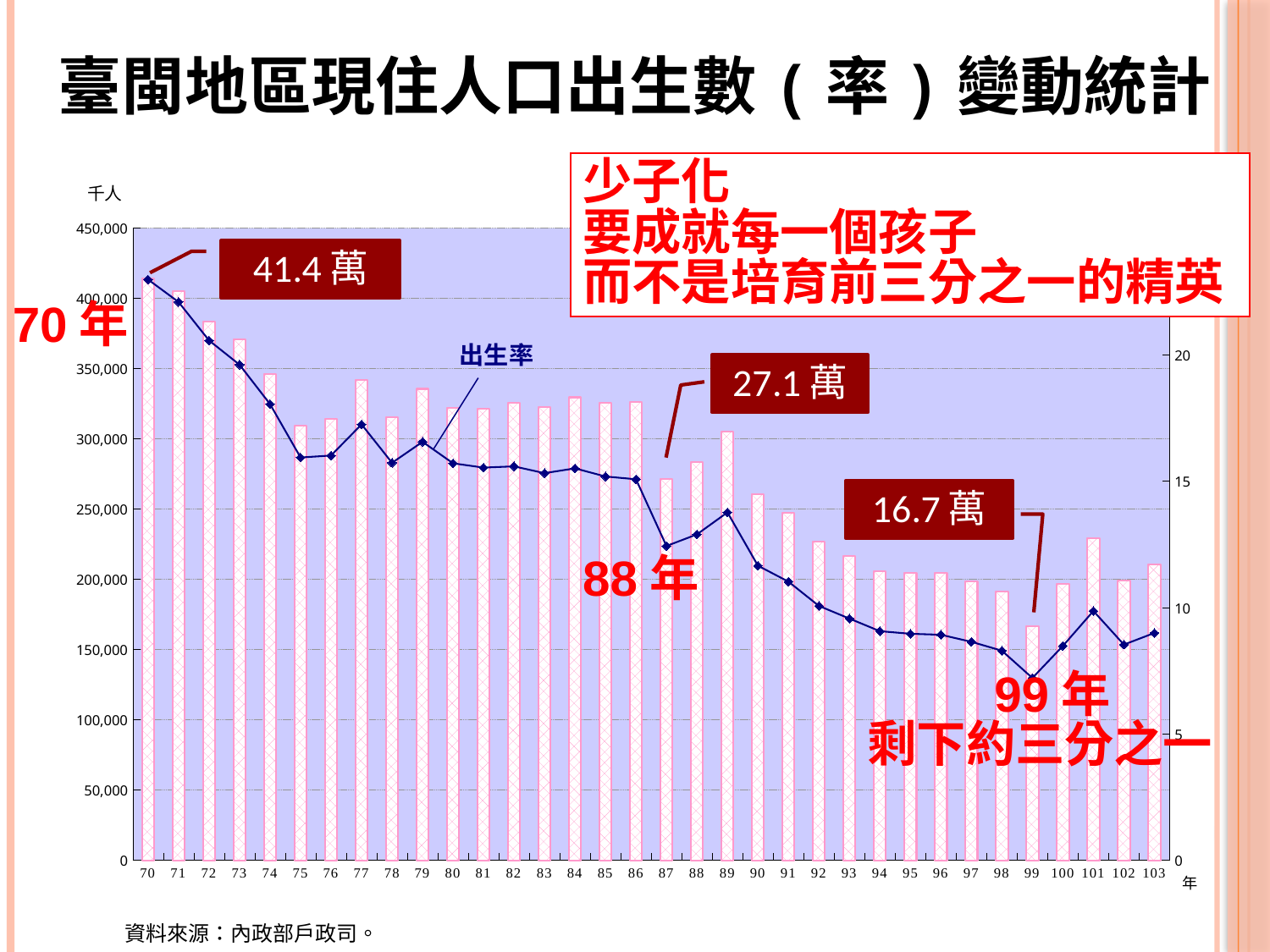
Overall, do the bars rise or fall from year 70 to year 103? Fall Is the bar for year 99 greater or less than 200,000? less What birth count is annotated for year 99? 16.7 萬 Which year has the tallest bar (highest number of births)? 70 What kind of chart is shown on the slide? A combined bar and line chart Which year has a taller bar, 89 or 90? 89 What is the data source stated below the chart? 內政部戶政司 Is the bar for year 70 greater or less than 400,000? greater What birth count is annotated for year 88? 27.1 萬 What birth count is annotated for year 70? 41.4 萬 How many years (categories) are plotted along the x axis? 34 Which year has the shortest bar (lowest number of births)? 99